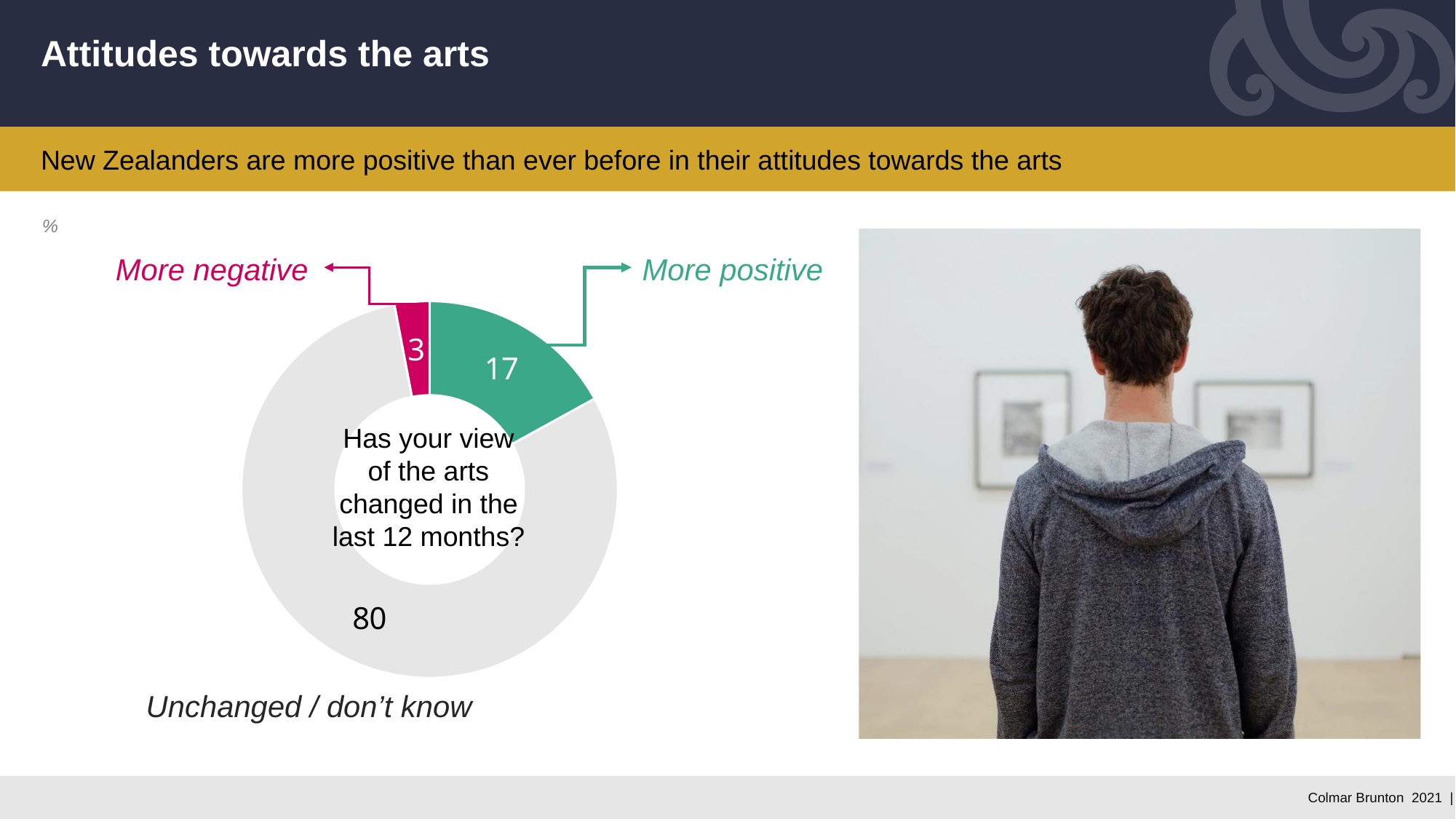
What is the combined percentage of respondents whose view became more positive or more negative? 20 What kind of chart is shown on the slide? Pie chart (donut) What percentage of respondents said their view of the arts had become more negative? 3 What colour is the 'More positive' segment of the chart? Green Which is larger, the 'More positive' share or the 'More negative' share? More positive What percentage of respondents said their view was unchanged or they didn't know? 80 Which category has the smallest share of the chart? More negative How many categories are shown in the chart? 3 What is the difference between the 'More positive' and 'More negative' percentages? 14 Which category has the largest share of the chart? Unchanged / don't know What question is written in the centre of the chart? Has your view of the arts changed in the last 12 months? What percentage of respondents said their view of the arts had become more positive? 17